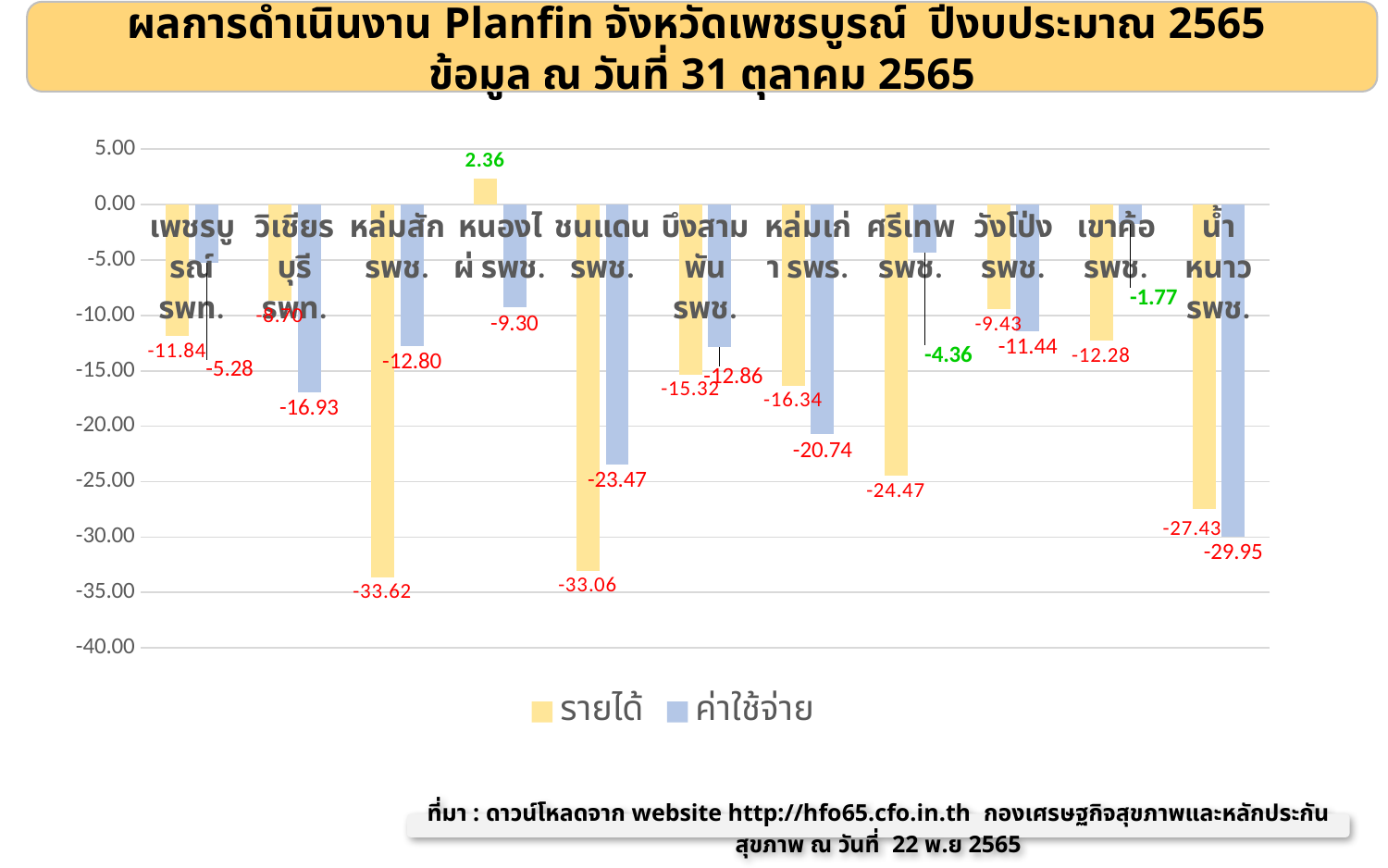
What is the รายได้ value for ศรีเทพ รพช.? -24.47 Which category has the highest รายได้ value? หนองไผ่ รพช. Which category has the highest ค่าใช้จ่าย value? เขาค้อ รพช. What kind of chart is shown on the slide? bar chart How many series does the legend list? 2 Which category has the lowest ค่าใช้จ่าย value? น้ำหนาว รพช. How many categories are shown on the x axis? 11 What is the ค่าใช้จ่าย value for น้ำหนาว รพช.? -29.95 What is the รายได้ value for หนองไผ่ รพช.? 2.36 What is the difference between the รายได้ and ค่าใช้จ่าย values for เพชรบูรณ์ รพท.? 6.56 Is the ค่าใช้จ่าย value for หล่มเก่า รพร. greater or less than -20.00? less For ชนแดน รพช., which is larger: รายได้ or ค่าใช้จ่าย? ค่าใช้จ่าย